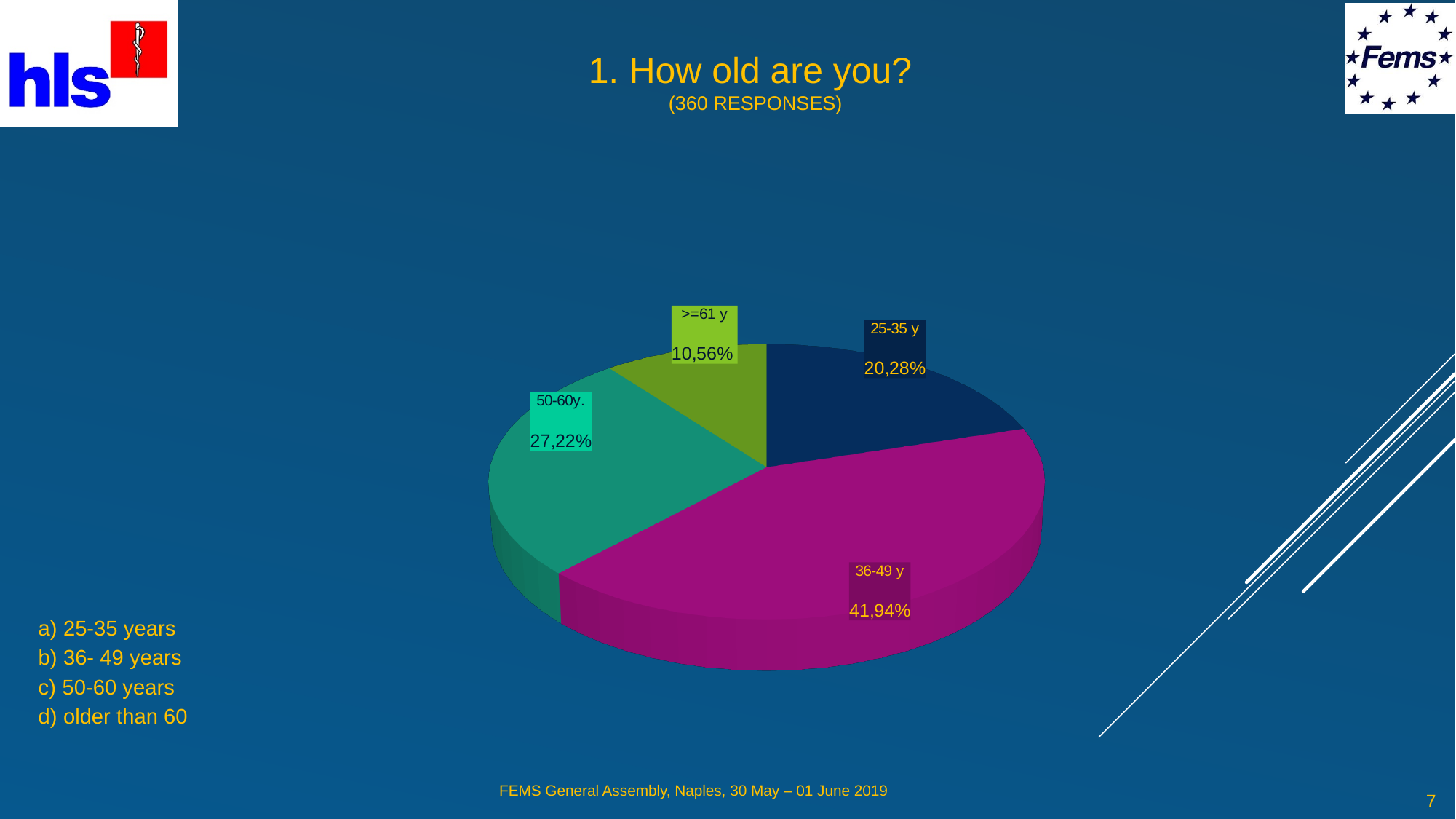
What kind of chart is shown on the slide? pie chart What share of respondents are in the 25-35 y age group? 20,28% How many slices does the pie chart have? 4 Which age group has the largest share of the pie? 36-49 y What share of respondents are in the >=61 y age group? 10,56% What share of respondents are in the 50-60y. age group? 27,22% Which age group has the smallest share of the pie? >=61 y What share of respondents are in the 36-49 y age group? 41,94% What is the title of the chart on the slide? 1. How old are you? What is the difference in percentage points between the 36-49 y share and the 50-60y. share? 14,72 Which is larger, the share for 50-60y. or the share for 25-35 y? 50-60y. How many responses does the chart subtitle say were collected? 360